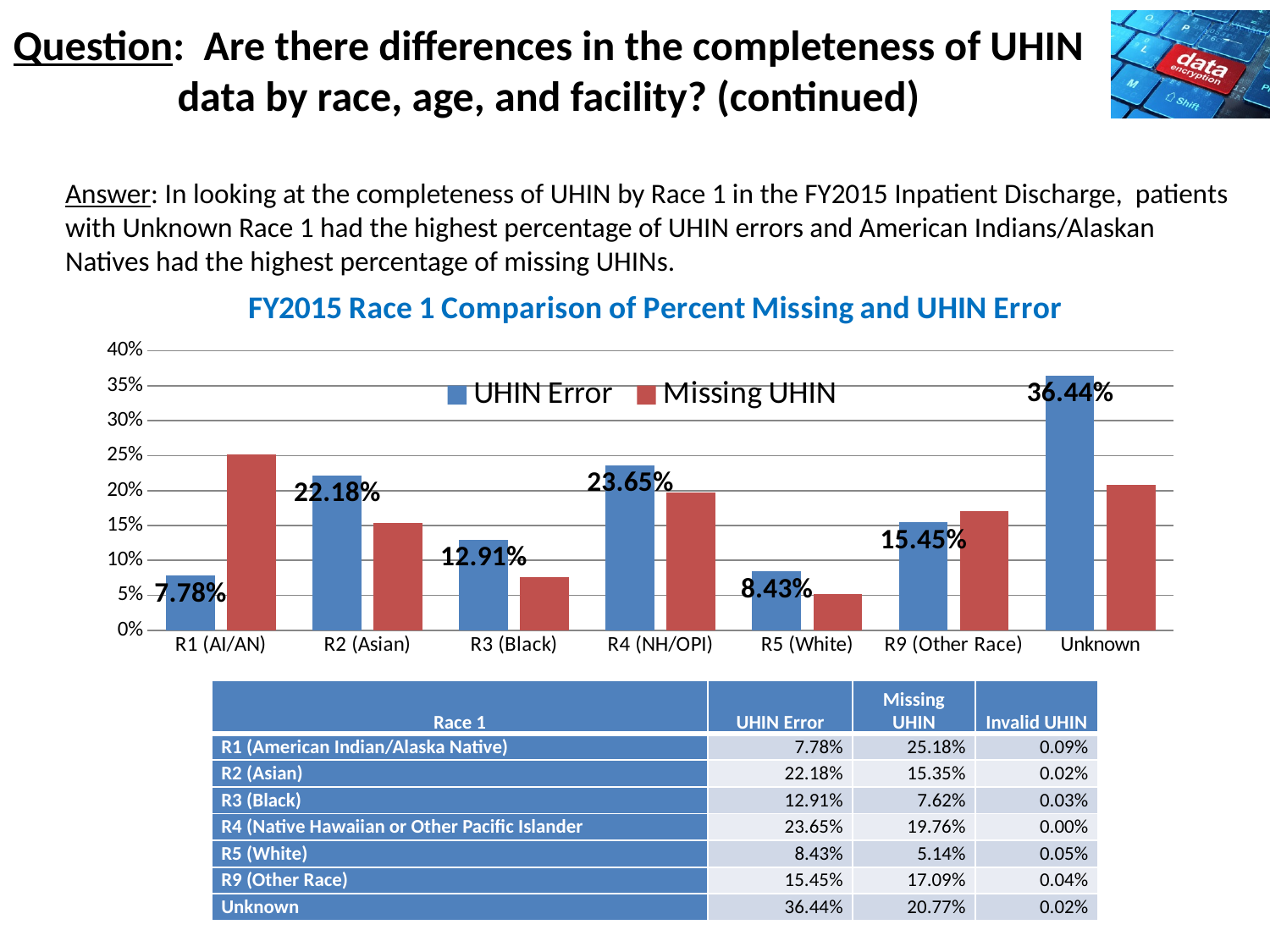
Which is larger, the UHIN Error value for R9 (Other Race) or for R5 (White)? R9 (Other Race) Which category has the lowest UHIN Error value? R1 (AI/AN) How many series does the chart legend list? 2 How many race categories are shown on the x axis of the chart? 7 What is the title of the chart? FY2015 Race 1 Comparison of Percent Missing and UHIN Error Which category has the highest UHIN Error value? Unknown What is the difference between the UHIN Error values for R4 (NH/OPI) and R3 (Black)? 10.74% Is the Missing UHIN value for R5 (White) greater or less than 10%? less What is the UHIN Error value for Unknown? 36.44% What kind of chart is shown on the slide? Bar chart Is the Missing UHIN value for R1 (AI/AN) greater or less than 20%? greater What is the UHIN Error value for R2 (Asian)? 22.18%